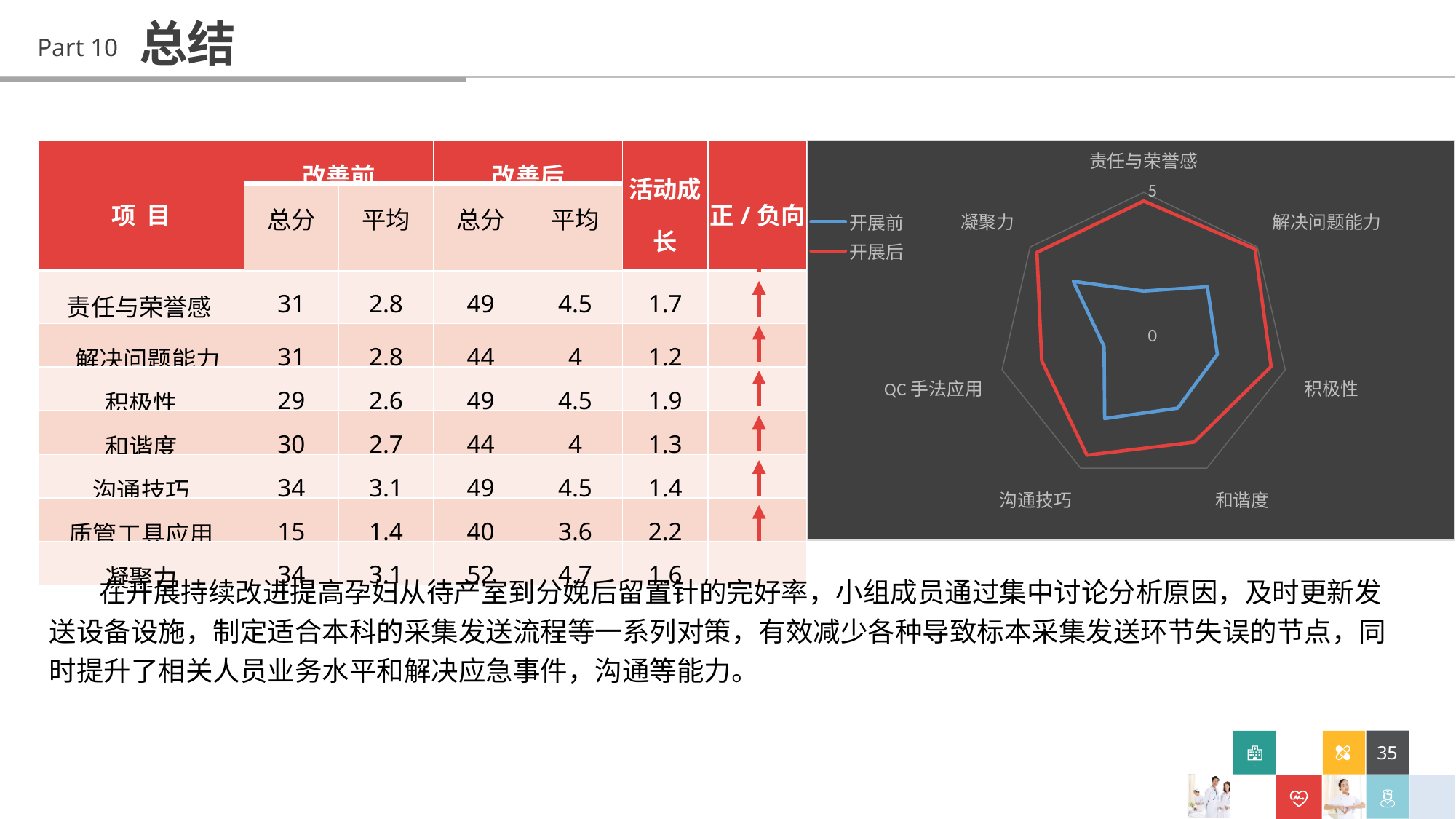
Which series in the radar chart is drawn in red? 开展后 Which series in the radar chart is drawn in blue? 开展前 In the radar chart, is the 开展后 value for 责任与荣誉感 greater or less than 5? less How many series does the legend of the radar chart list? 2 What is the maximum value shown on the radar chart's axis scale? 5 What kind of chart is shown on the right side of the slide? radar chart How many categories (axes) does the radar chart have? 7 In the radar chart, which series has the larger value for QC 手法应用, 开展前 or 开展后? 开展后 In the radar chart, is the 开展前 value for 积极性 greater or less than 5? less In the radar chart, which series has the larger value for 责任与荣誉感, 开展前 or 开展后? 开展后 In the radar chart, which category has the lowest value for the 开展前 series? QC 手法应用